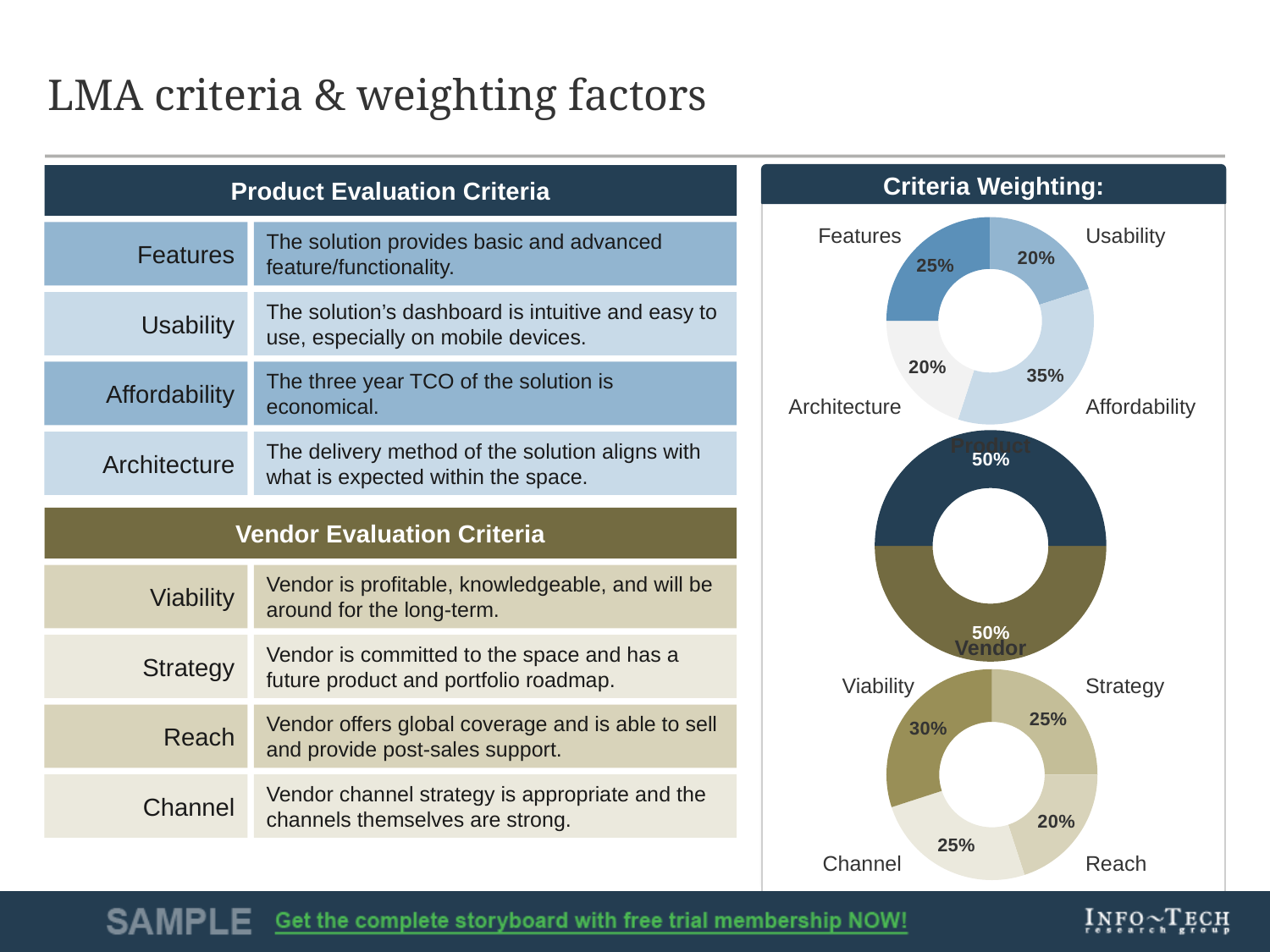
In the middle doughnut chart under Criteria Weighting, what is the weighting for Vendor? 50% In the bottom doughnut chart under Criteria Weighting, which is larger, the weighting for Viability or for Strategy? Viability What type of chart is used for the Criteria Weighting charts on the right of the slide? Doughnut chart In the top doughnut chart under Criteria Weighting, what is the weighting for Affordability? 35% In the middle doughnut chart under Criteria Weighting, how many segments are shown? 2 In the bottom doughnut chart under Criteria Weighting, which criterion has the lowest weighting? Reach In the bottom doughnut chart under Criteria Weighting, what is the difference between the Viability and Reach weightings? 10% In the top doughnut chart under Criteria Weighting, what is the weighting for Features? 25% In the top doughnut chart under Criteria Weighting, how many criteria are shown? 4 In the top doughnut chart under Criteria Weighting, which criterion has the highest weighting? Affordability In the top doughnut chart under Criteria Weighting, what is the difference between the Affordability and Usability weightings? 15% In the bottom doughnut chart under Criteria Weighting, what is the weighting for Viability? 30%